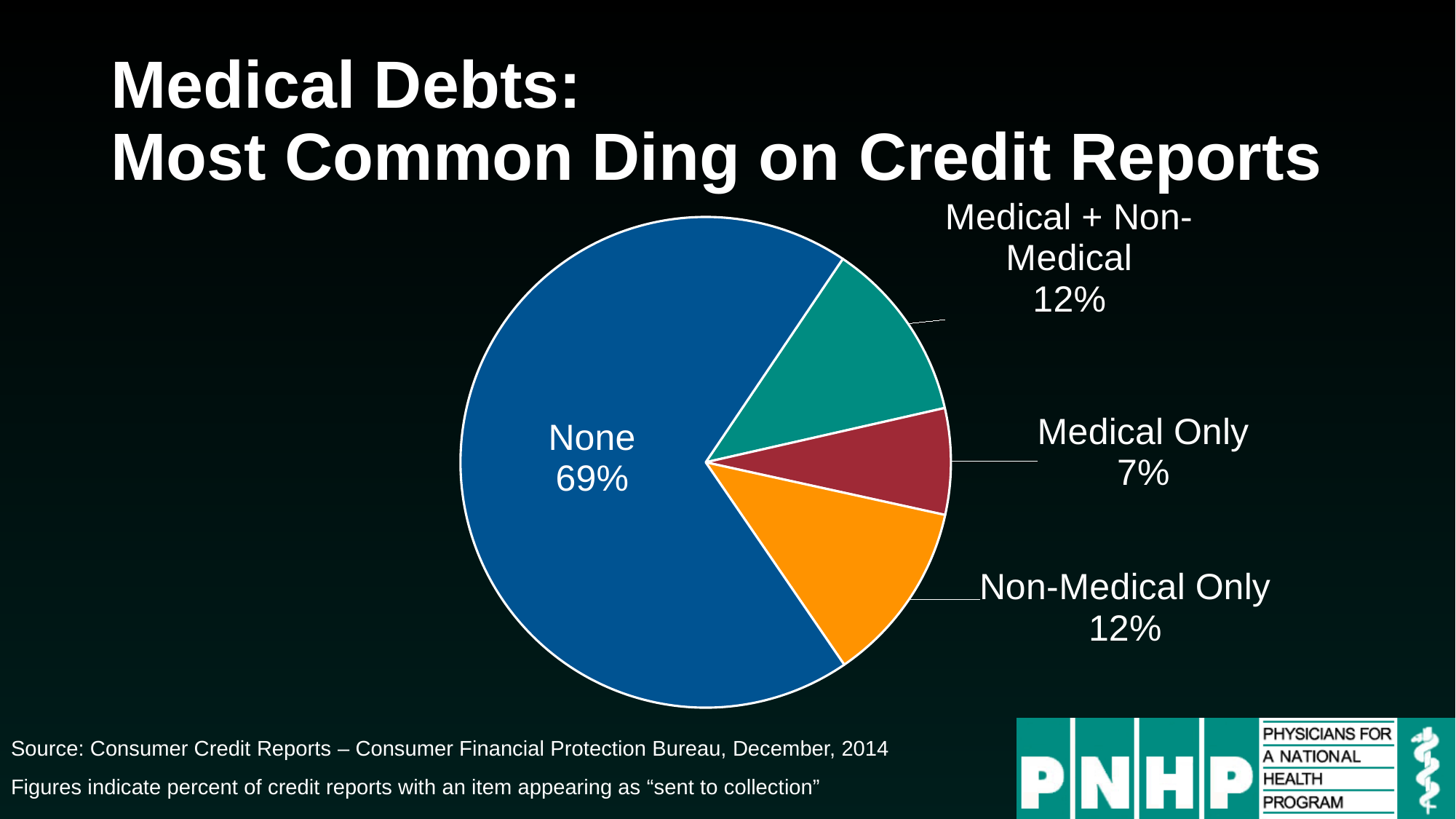
What is the value of the 'Medical + Non-Medical' slice? 12% What is the difference between the 'Non-Medical Only' slice and the 'Medical Only' slice? 5% Which slice of the pie is the largest? None What is the value of the 'Non-Medical Only' slice? 12% How many slices does the pie chart have? 4 Which is larger, the 'Medical + Non-Medical' slice or the 'Medical Only' slice? Medical + Non-Medical What colour is the 'Non-Medical Only' slice? Orange What percentage of credit reports have no item sent to collection (the 'None' slice)? 69% What is the difference between the 'None' slice and the 'Medical Only' slice? 62% Which slice of the pie is the smallest? Medical Only What kind of chart is shown on the slide? Pie chart What is the value of the 'Medical Only' slice? 7%